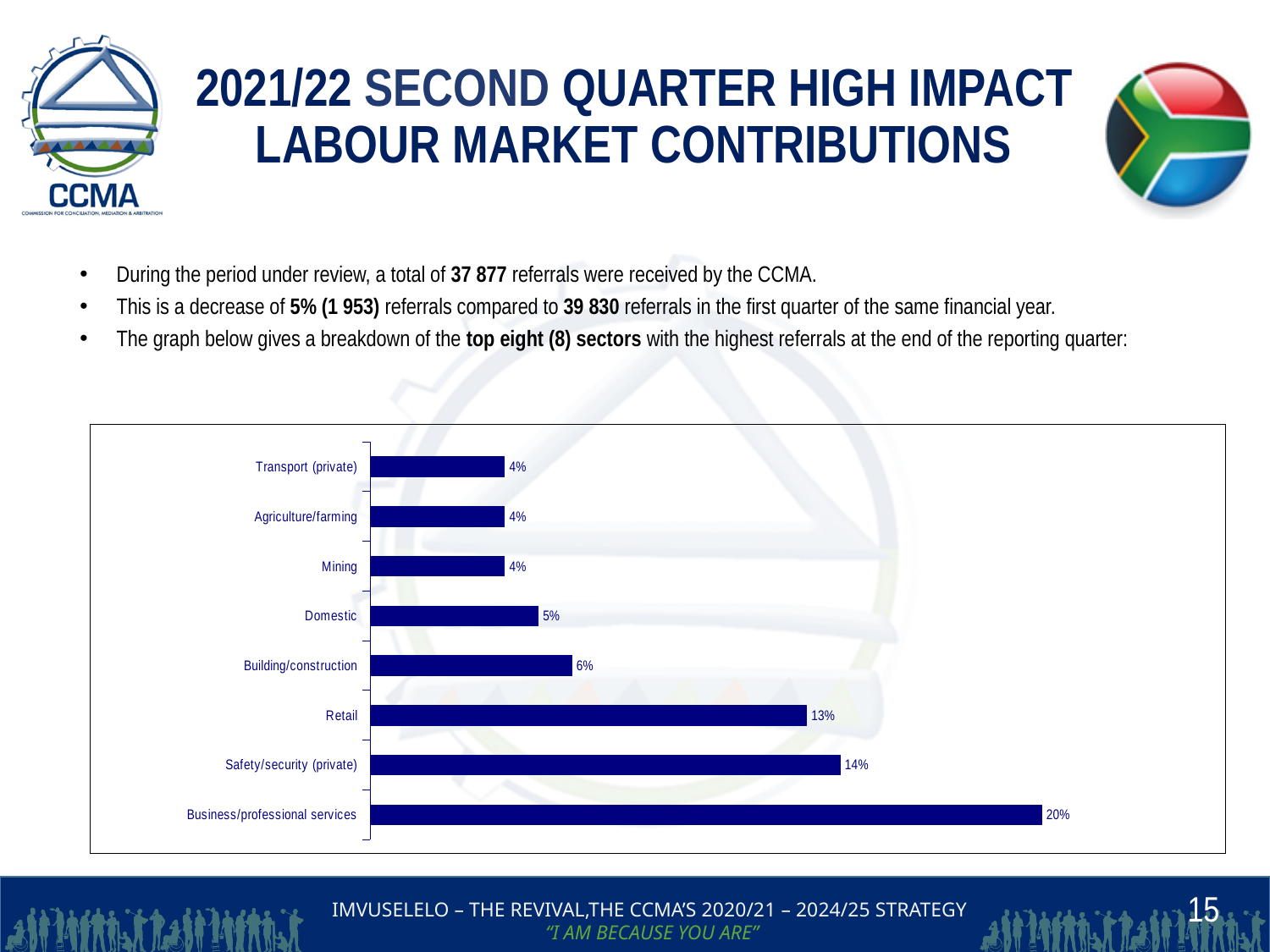
What is the value for Building/construction? 6% How many sectors are shown in the chart? 8 What is the value for Domestic? 5% What is the value for Business/professional services? 20% What is the value for Retail? 13% Which sector has the highest value? Business/professional services What is the difference between Business/professional services and Safety/security (private)? 6% What kind of chart is shown on the slide? Bar chart Which is larger, Retail or Domestic? Retail What is the difference between Retail and Building/construction? 7% What is the value for Safety/security (private)? 14% How many sectors have a value of 4%? 3